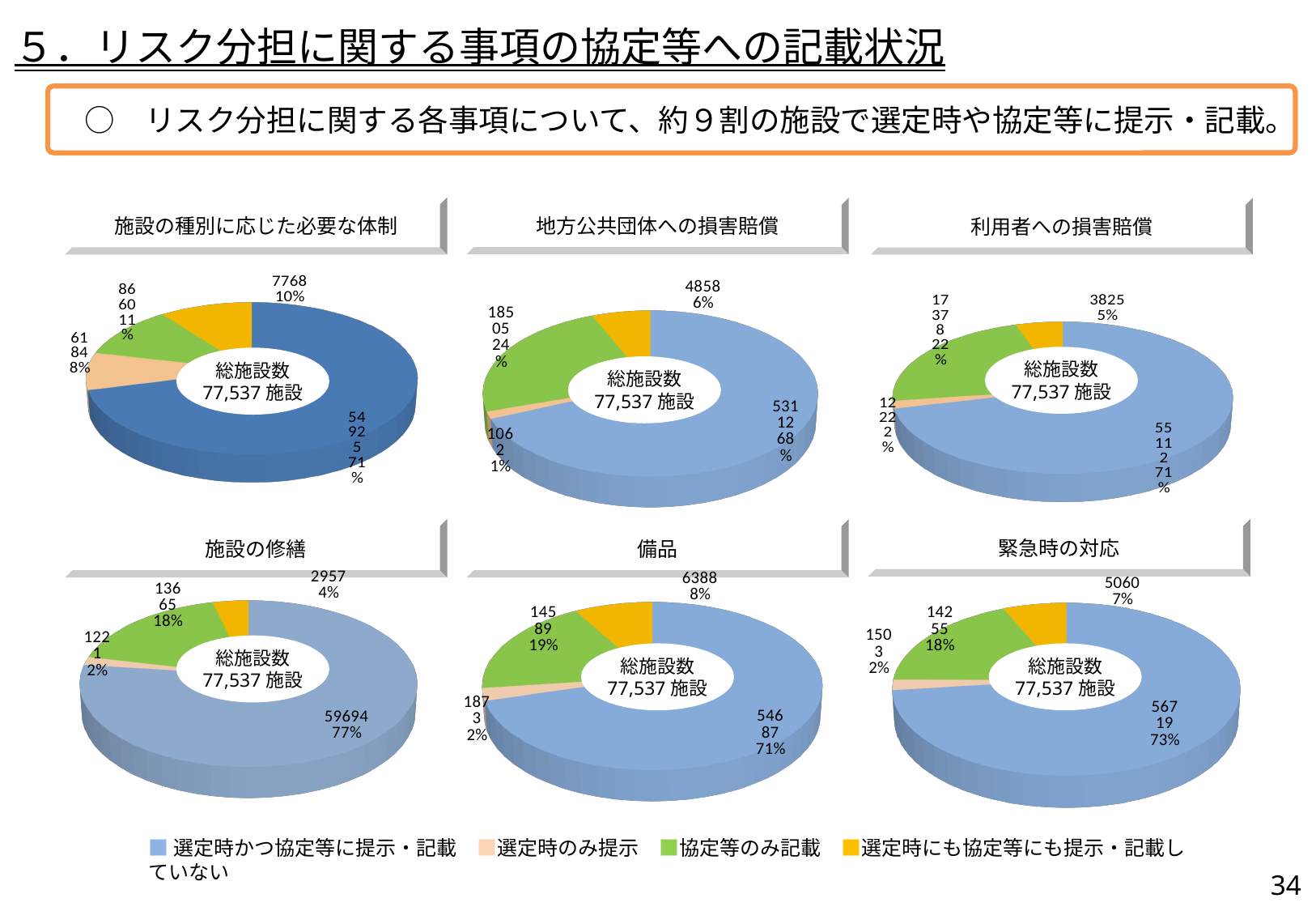
What total number of facilities is shown in the centre of each chart? 77,537 施設 In the 地方公共団体への損害賠償 chart, which category has the largest share? 選定時かつ協定等に提示・記載 In the 備品 chart, which is larger: the share for 協定等のみ記載 or the share for 選定時にも協定等にも提示・記載していない? 協定等のみ記載 How many entries does the legend list? 4 In the 備品 chart, what percentage is shown for 選定時にも協定等にも提示・記載していない? 8% In the 施設の修繕 chart, what percentage is shown for 選定時かつ協定等に提示・記載? 77% In the 利用者への損害賠償 chart, which category has the smallest share? 選定時のみ提示 What kind of chart is used for 施設の修繕? pie chart In the 施設の種別に応じた必要な体制 chart, what is the difference in percentage points between 協定等のみ記載 (11%) and 選定時のみ提示 (8%)? 3 In the 施設の修繕 chart, what is the number of facilities for 選定時かつ協定等に提示・記載? 59694 In the 緊急時の対応 chart, what is the number of facilities for 選定時にも協定等にも提示・記載していない? 5060 How many slices does the 緊急時の対応 chart have? 4